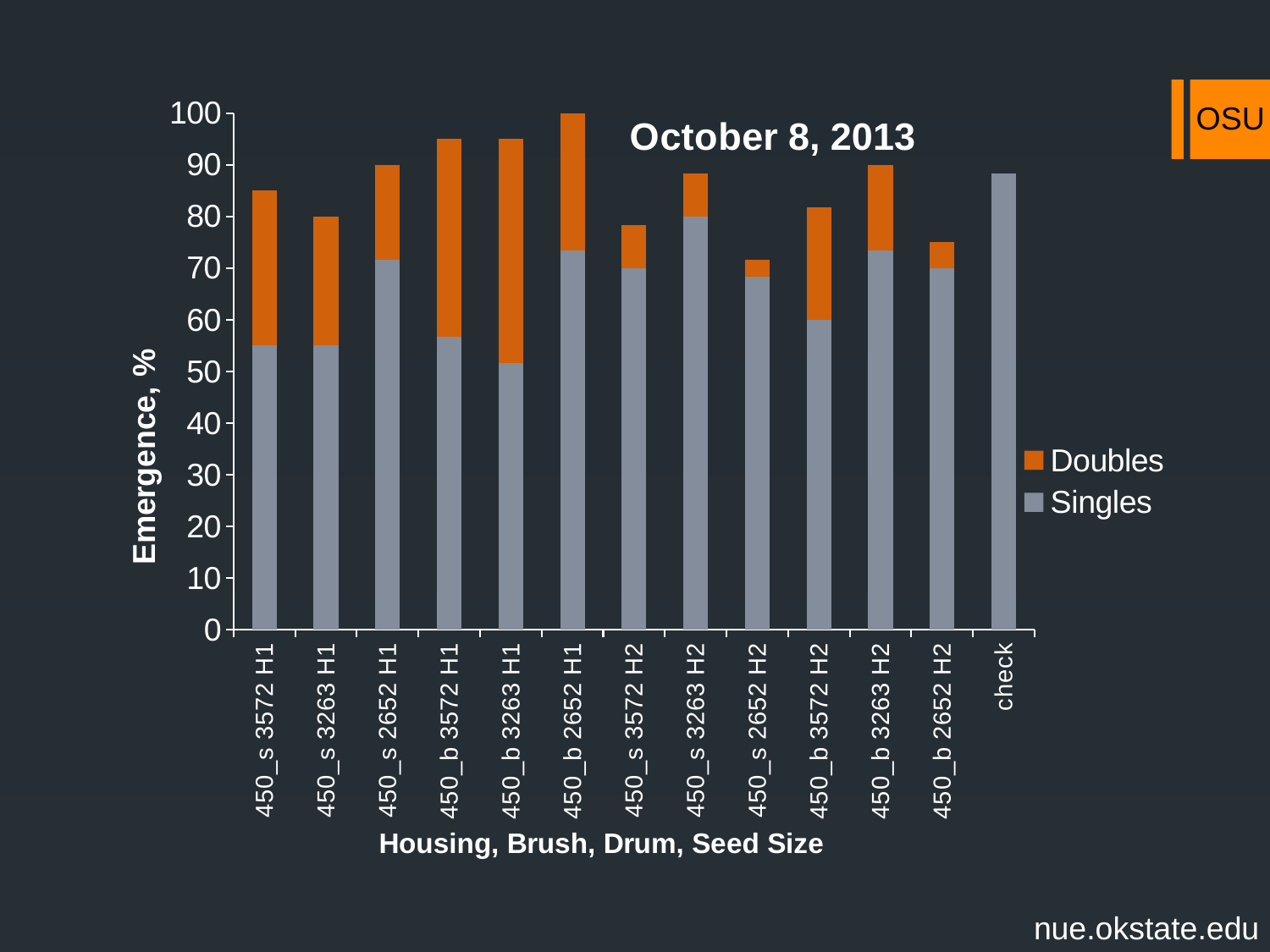
Is the Singles value for 450_s 3572 H1 greater or less than 60? less Which has the larger Singles value, 450_s 3263 H2 or 450_s 3572 H2? 450_s 3263 H2 What is the title of the chart? October 8, 2013 Is the value for check greater or less than 80? greater What kind of chart is shown on the slide? bar chart Is the Singles value for 450_b 3263 H1 greater or less than 60? less How many series does the legend list? 2 Which category has the lowest total emergence? 450_s 2652 H2 How many categories are shown on the x axis? 13 Which category has the highest total emergence? 450_b 2652 H1 What is the total emergence for 450_b 2652 H1? 100